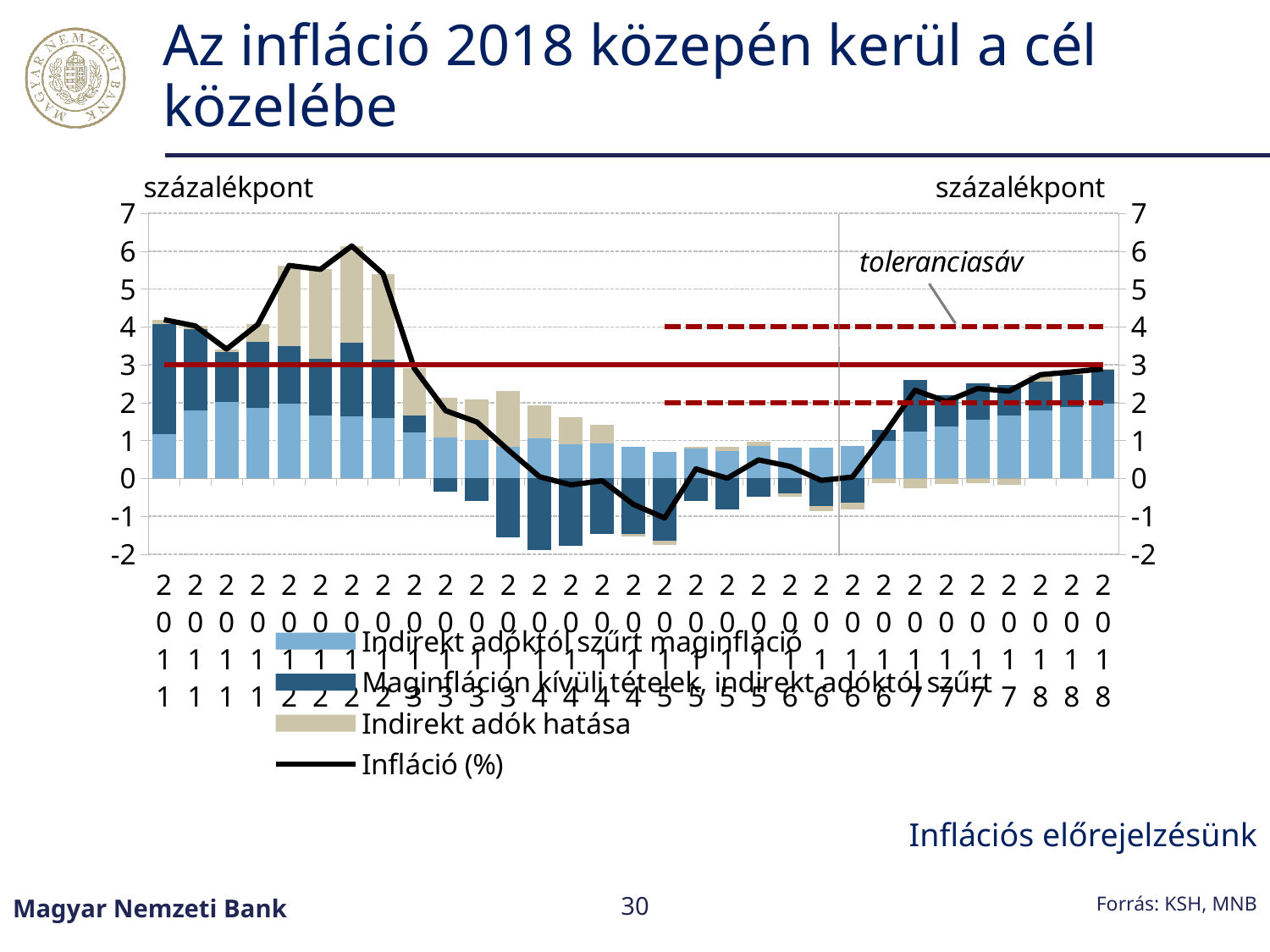
Does the Infláció (%) line rise or fall from 2016 to 2018? rise At what value on the axis does the solid red horizontal line sit? 3 How many series does the legend list? 4 What kind of chart is shown on the slide? Stacked bar chart with a line Is the peak value of the Infláció (%) line in 2012 greater or less than 5? greater What is the title of the slide chart? Az infláció 2018 közepén kerül a cél közelébe In which year does the Infláció (%) line reach its highest point? 2012 At what values on the axis do the two dashed red lines (toleranciasáv) sit? 2 and 4 Is the lowest value of the Infláció (%) line, reached in early 2015, greater or less than 0? less Which legend entry is drawn as a line rather than bars? Infláció (%) What unit label is shown at the top of the vertical axes? százalékpont Does the Infláció (%) line rise or fall from its 2012 peak to 2015? fall